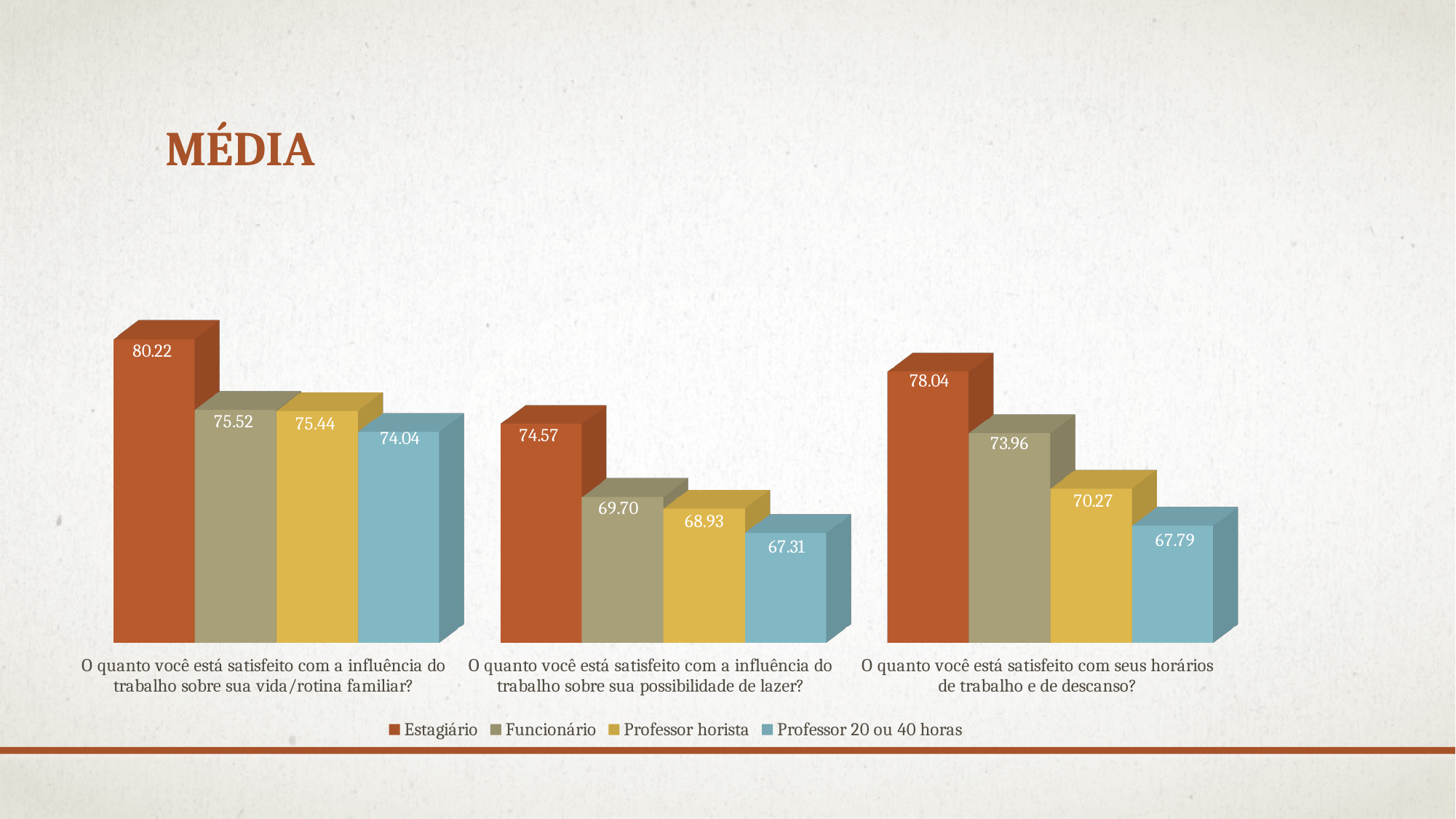
What is the value for Funcionário in the category about the possibility of leisure (possibilidade de lazer)? 69.70 What is the title of the chart? MÉDIA Which is larger: the Estagiário value for the family life/routine category or the Estagiário value for the possibility of leisure category? Family life/routine (80.22) Which series has the highest value in the category about work and rest schedules (horários de trabalho e de descanso)? Estagiário How many question categories are shown on the x axis? 3 Which series has the lowest value in the category about the influence of work on family life/routine (vida/rotina familiar)? Professor 20 ou 40 horas What is the value for Estagiário in the category about the influence of work on family life/routine (vida/rotina familiar)? 80.22 What is the difference between the Estagiário and Professor 20 ou 40 horas values in the category about work and rest schedules (horários de trabalho e de descanso)? 10.25 How many series does the legend list? 4 What is the value for Professor horista in the category about work and rest schedules (horários de trabalho e de descanso)? 70.27 What type of chart is shown on the slide? Bar chart What is the value for Professor 20 ou 40 horas in the category about the possibility of leisure (possibilidade de lazer)? 67.31